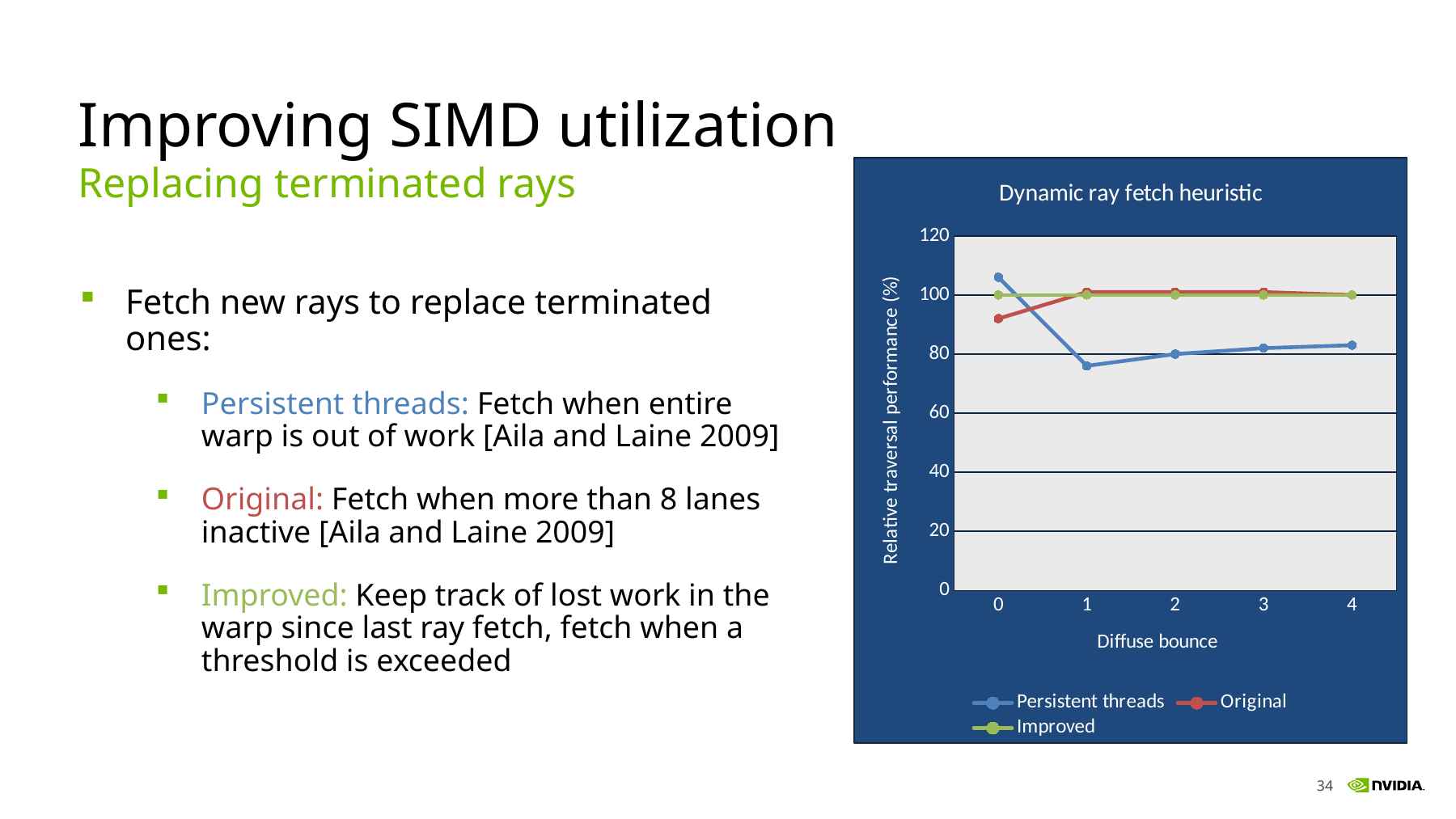
Is the value for Persistent threads at diffuse bounce 1 greater or less than 80? less Is the value for Persistent threads at diffuse bounce 0 greater or less than 100? greater How many series does the chart legend list? 3 What is the title of the chart? Dynamic ray fetch heuristic Which series has the highest value at diffuse bounce 0? Persistent threads Does the Persistent threads series rise or fall from diffuse bounce 0 to diffuse bounce 1? fall Which series has the lowest value at diffuse bounce 3? Persistent threads How many diffuse bounce values are plotted along the x axis? 5 Is the value for Original at diffuse bounce 0 greater or less than 100? less What is the label of the y axis? Relative traversal performance (%) What kind of chart is shown on the slide? line chart